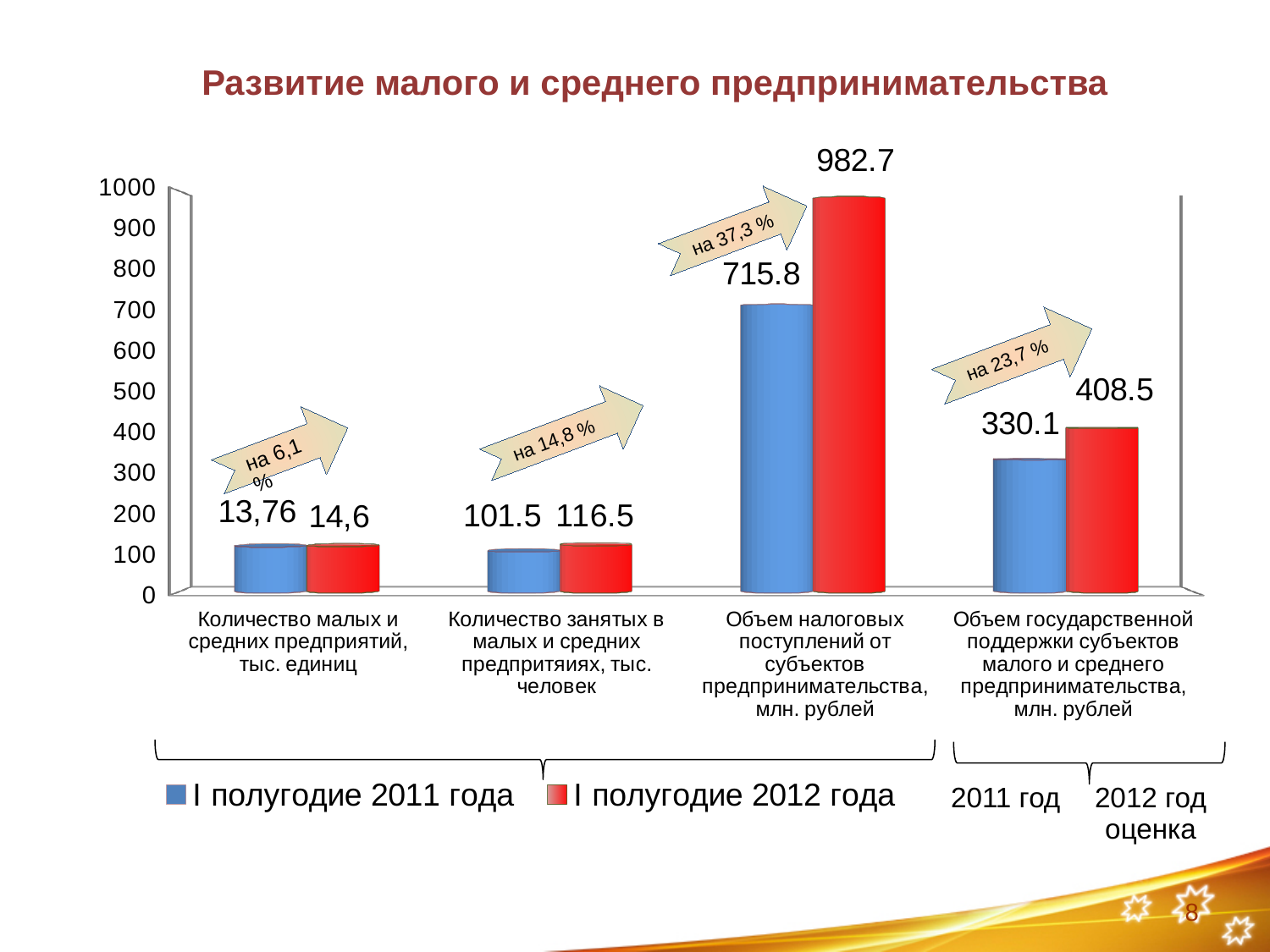
What is the value for 'Объем налоговых поступлений от субъектов предпринимательства, млн. рублей' in the 'I полугодие 2012 года' series? 982.7 What is the value for 'Объем налоговых поступлений от субъектов предпринимательства, млн. рублей' in the 'I полугодие 2011 года' series? 715.8 How many series does the legend list? 2 What is the value for 'Количество малых и средних предприятий, тыс. единиц' in the 'I полугодие 2012 года' series? 14,6 Which category has the highest value in the 'I полугодие 2012 года' series? Объем налоговых поступлений от субъектов предпринимательства, млн. рублей What is the difference between the 2012 and 2011 values for 'Объем налоговых поступлений от субъектов предпринимательства, млн. рублей'? 266.9 What type of chart is shown on the slide? bar chart Which is larger for 'Объем государственной поддержки субъектов малого и среднего предпринимательства, млн. рублей': the 2011 value or the 2012 value? 2012 value (408.5) What is the value for 'Объем государственной поддержки субъектов малого и среднего предпринимательства, млн. рублей' in the 'I полугодие 2011 года' series? 330.1 What is the value for 'Количество занятых в малых и средних предпритяиях, тыс. человек' in the 'I полугодие 2012 года' series? 116.5 How many categories are shown on the x axis? 4 What percentage increase is shown by the arrow above 'Объем налоговых поступлений от субъектов предпринимательства, млн. рублей'? на 37,3 %